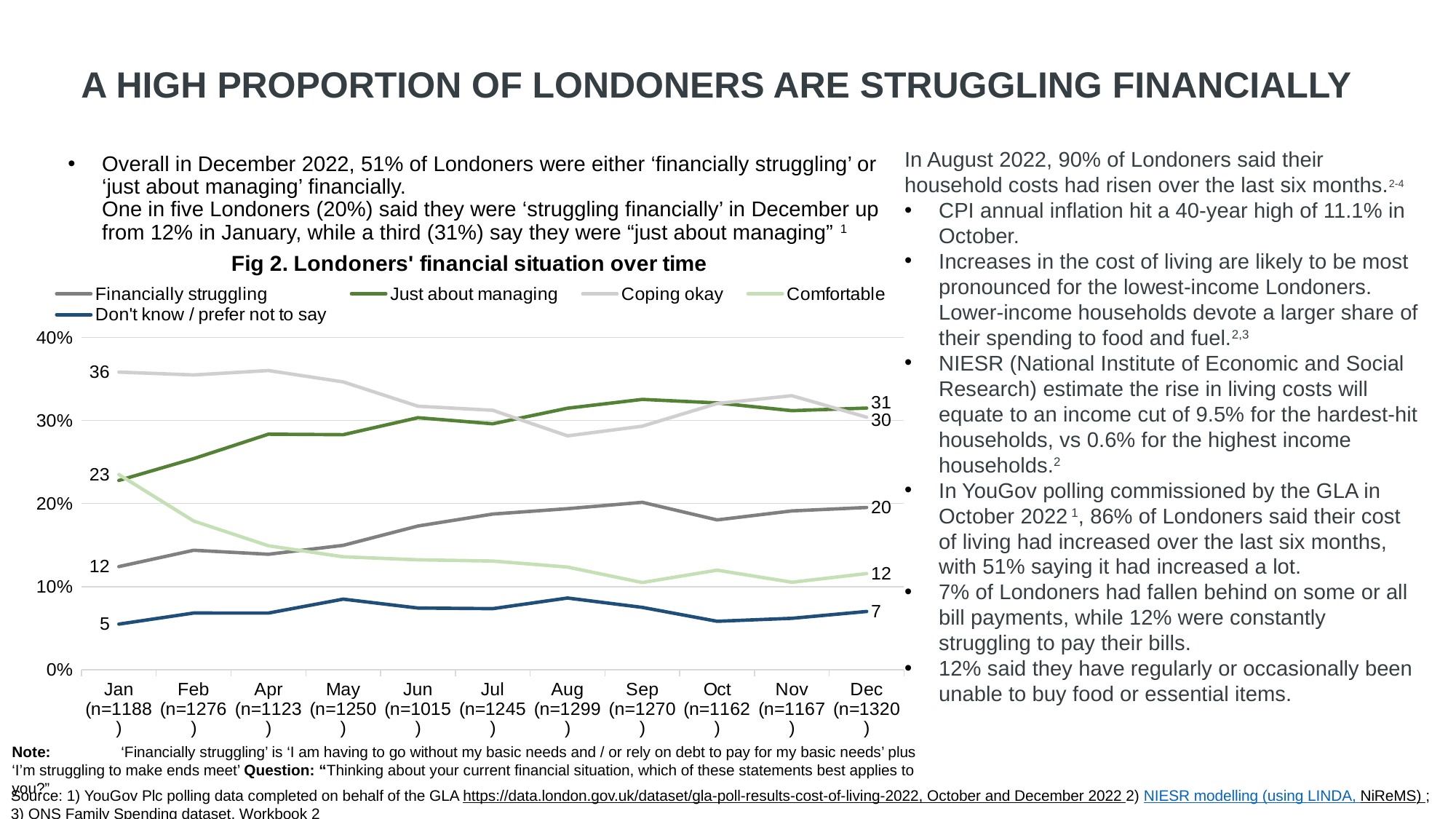
How many series does the legend of Fig 2 list? 5 What is the value for 'Coping okay' in Jan? 36 Does the 'Comfortable' line rise or fall from Jan to Dec? fall What is the value for 'Comfortable' in Dec? 12 Is the value for 'Coping okay' in Apr greater or less than 30%? greater What kind of chart is Fig 2? line chart Which series has the highest value in Dec? Just about managing How many months are shown on the x axis of Fig 2? 11 What is the value for 'Financially struggling' in Dec? 20 What is the value for 'Just about managing' in Dec? 31 What is the value for 'Don't know / prefer not to say' in Jan? 5 By how much did 'Financially struggling' increase from Jan to Dec? 8